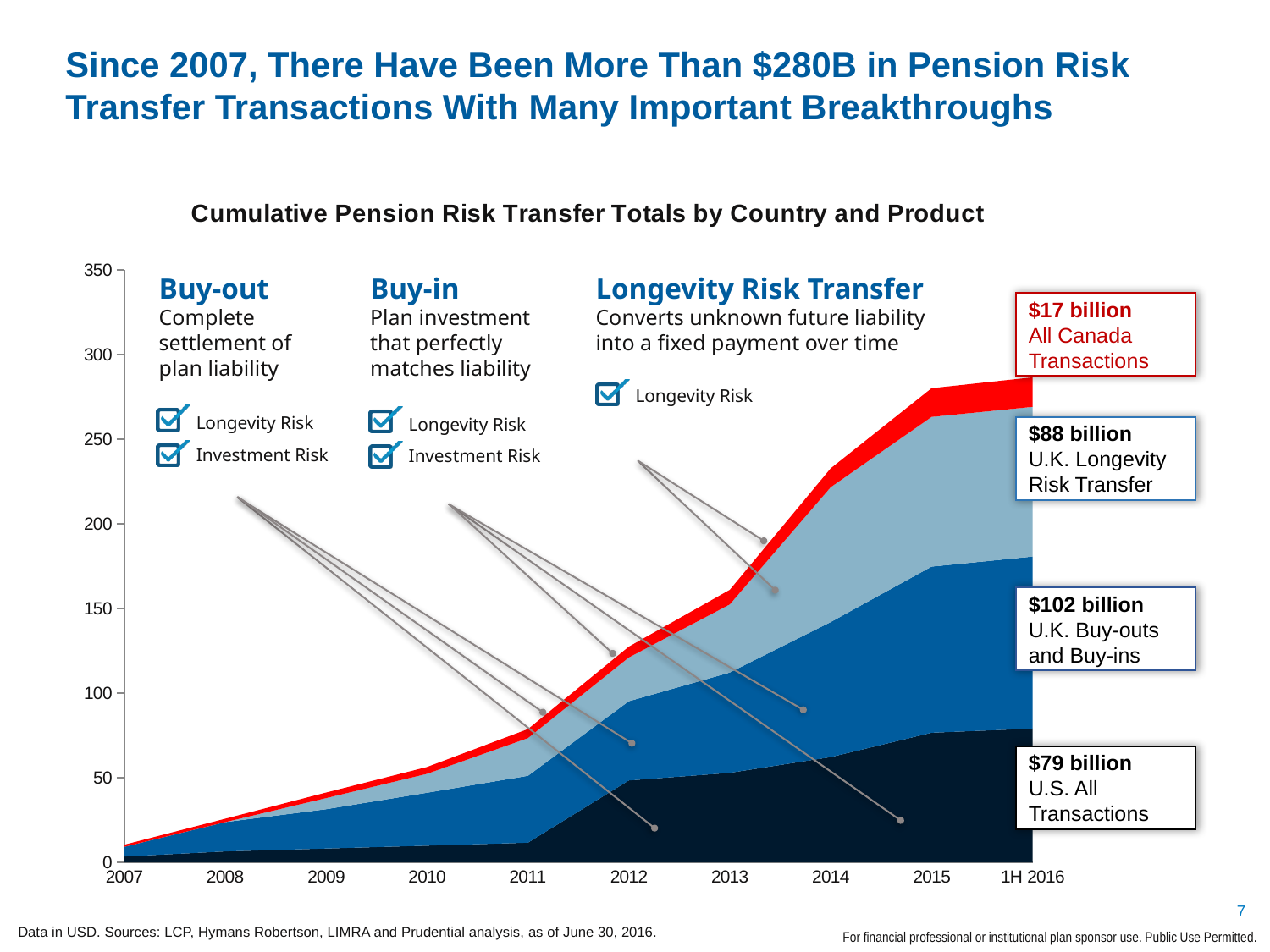
Which is larger, the labelled value for U.K. Longevity Risk Transfer or for U.S. All Transactions? U.K. Longevity Risk Transfer What is the difference between the labelled values for U.K. Buy-outs and Buy-ins and U.S. All Transactions? $23 billion What is the title of the chart? Cumulative Pension Risk Transfer Totals by Country and Product Which labelled segment has the smallest value? All Canada Transactions Do the cumulative totals rise or fall from 2007 to 1H 2016? Rise What kind of chart is shown on the slide? Stacked area chart What value is labelled for U.K. Longevity Risk Transfer? $88 billion Which labelled segment has the largest value? U.K. Buy-outs and Buy-ins What value is labelled for All Canada Transactions? $17 billion How many time points are shown along the x axis of the chart? 10 What value is labelled for U.S. All Transactions? $79 billion Is the total cumulative value in 2011 greater or less than 100? less